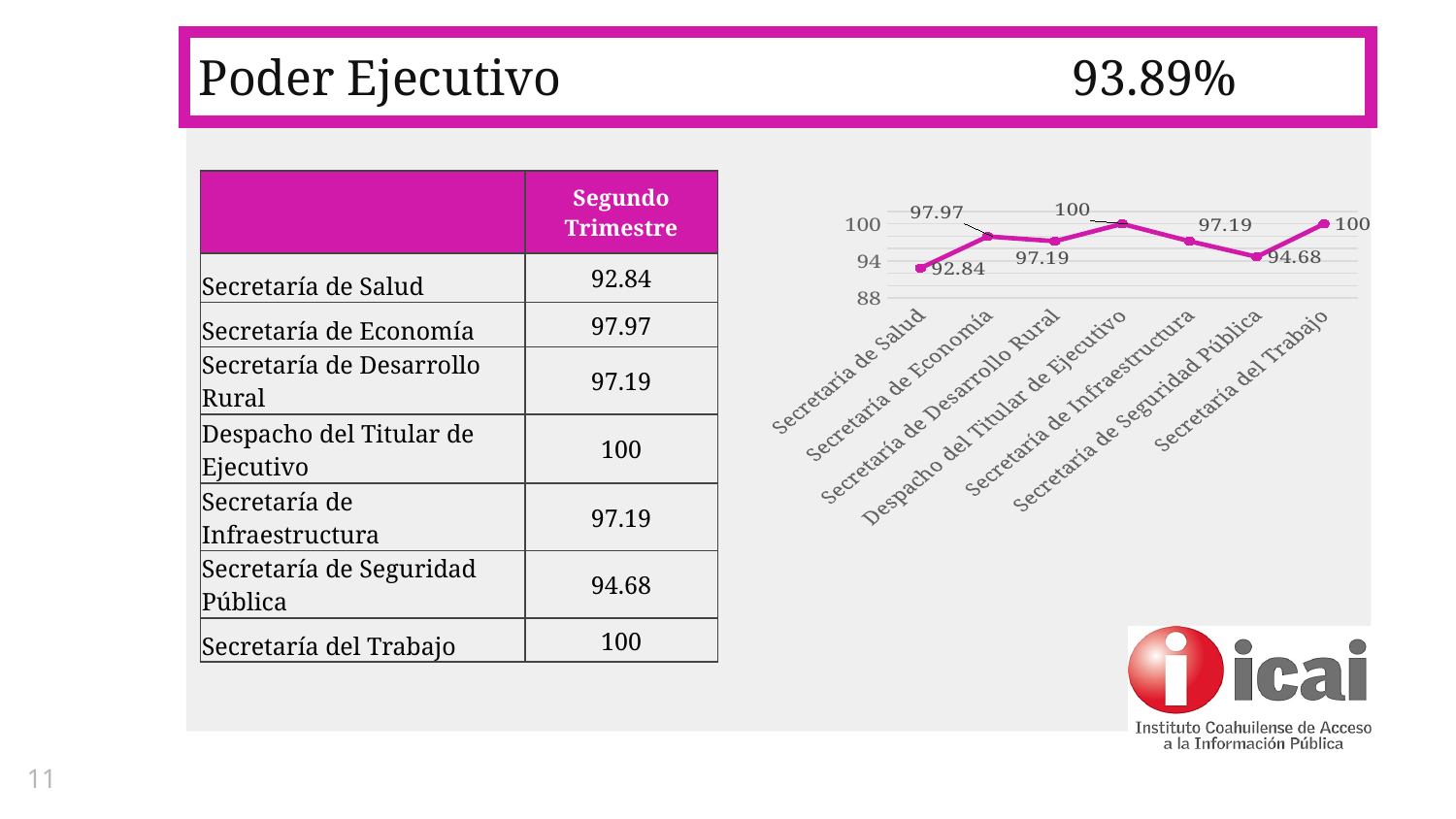
What is the value for Secretaría de Economía in the chart? 97.97 What type of chart is shown on the slide? line chart What is the difference between the values for Secretaría del Trabajo and Secretaría de Seguridad Pública? 5.32 What is the difference between the values for Secretaría de Economía and Secretaría de Salud? 5.13 What is the value for Secretaría de Salud in the chart? 92.84 What is the value for Despacho del Titular de Ejecutivo in the chart? 100 Which category has the lowest value in the chart? Secretaría de Salud Which is larger, the value for Secretaría de Desarrollo Rural or the value for Secretaría de Seguridad Pública? Secretaría de Desarrollo Rural How many categories are plotted in the chart? 7 What is the value for Secretaría de Seguridad Pública in the chart? 94.68 Is the value for Secretaría de Salud greater or less than 94? less Does the line rise or fall from Secretaría de Infraestructura to Secretaría de Seguridad Pública? fall